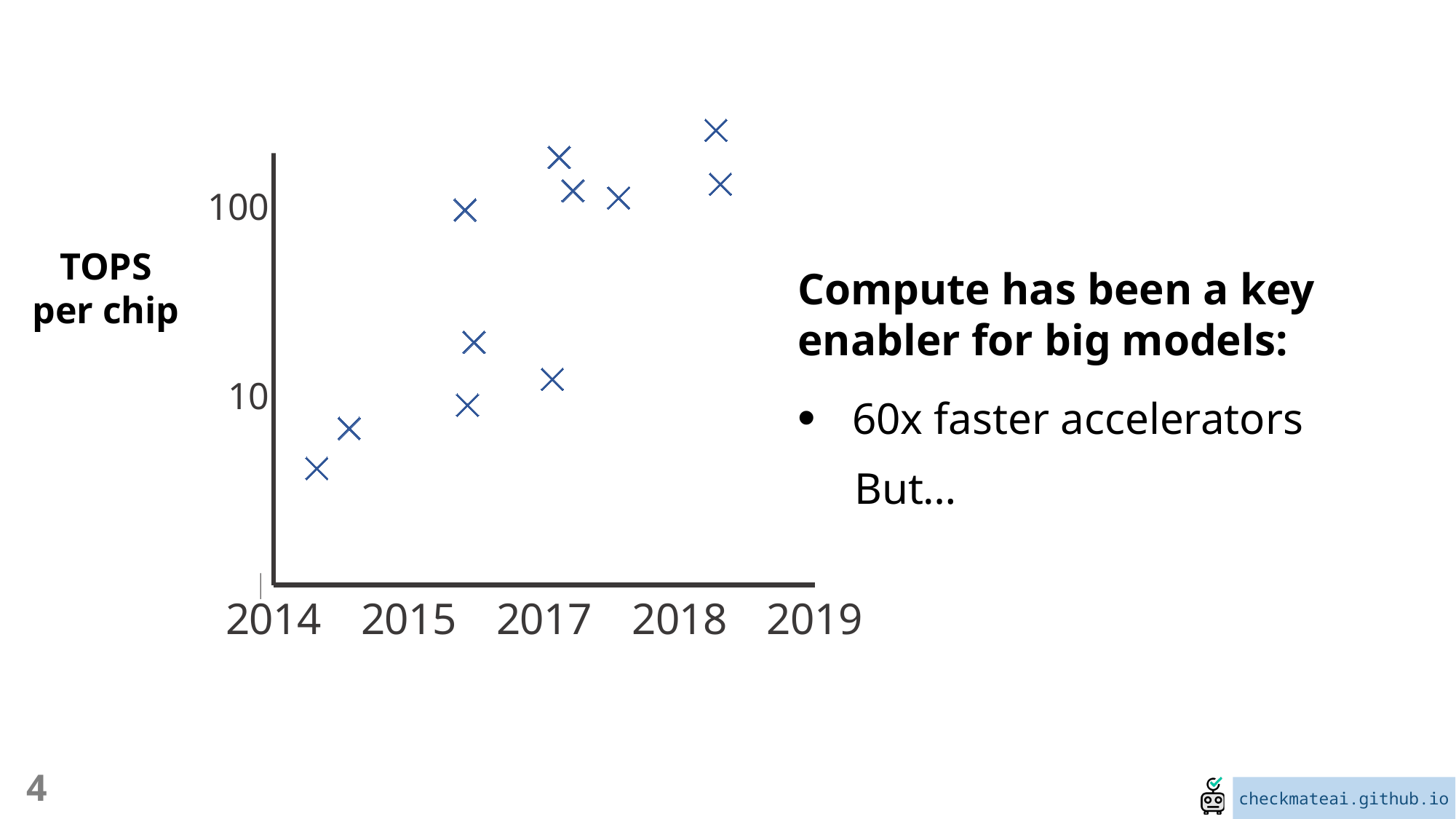
Is the value of the point plotted just before 2015 greater or less than 10? less What kind of chart is shown on the slide? scatter chart Which is larger: the highest point near 2018 or the highest point near 2017? the highest point near 2018 Is the value of the earliest plotted point (near 2014) greater or less than 10? less Near which year label is the highest plotted point located? 2018 Is the value of the lowest point plotted between 2017 and 2018 greater or less than 100? less Near which year label is the lowest plotted point located? 2014 How many year labels are shown on the x axis? 5 Do the plotted TOPS per chip values generally rise or fall from 2014 to 2019? rise What is the label on the y axis of the chart? TOPS per chip How many data points are plotted on the chart? 11